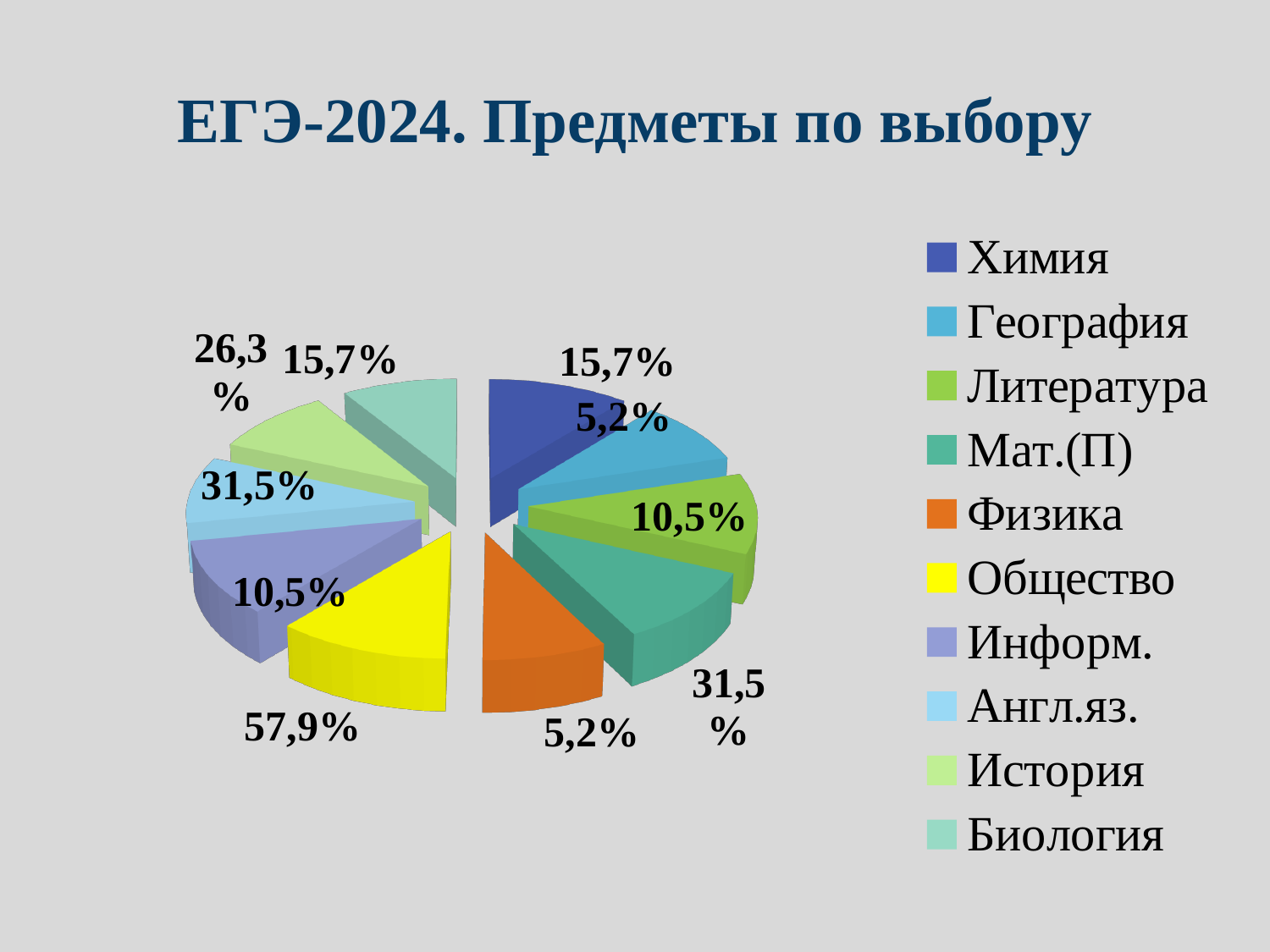
What kind of chart is shown on the slide? pie chart What is the title of the chart on the slide? ЕГЭ-2024. Предметы по выбору Which category has the highest value in the chart? Общество Which colour represents Общество in the legend? yellow What value is shown for Мат.(П)? 31,5% What value is shown for Химия? 15,7% What value is shown for Общество? 57,9% How many categories does the legend of the pie chart list? 10 What value is shown for Физика? 5,2% What is the difference between the values for Общество and Англ.яз.? 26,4% Which is larger, the value for Общество or the value for Мат.(П)? Общество What value is shown for История? 26,3%